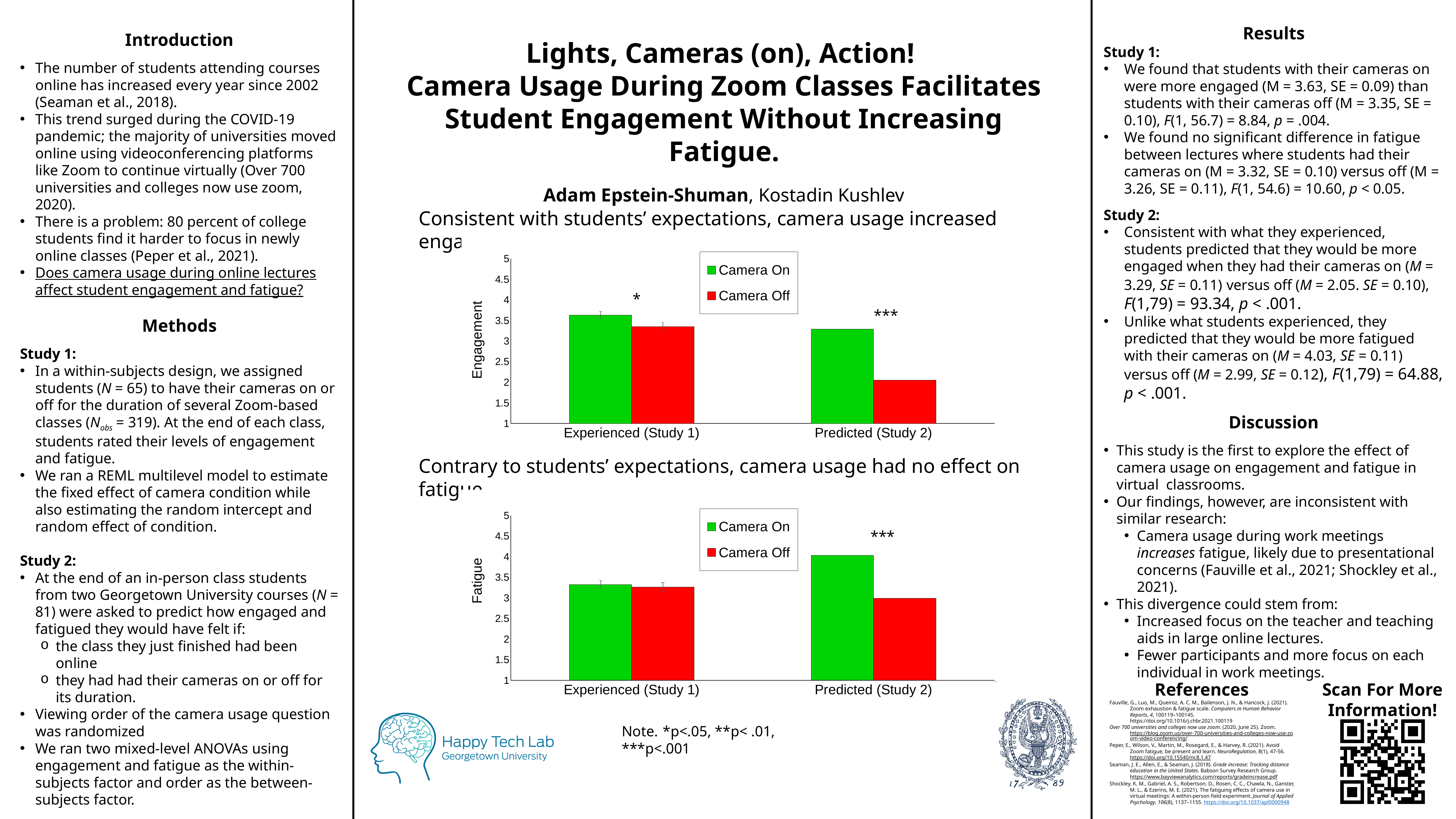
In the top chart (Engagement), how many categories are shown on the x axis? 2 In the bottom chart (Fatigue), what colour are the Camera On bars? green In the bottom chart (Fatigue), what is the highest value shown on the y axis? 5 What kind of chart is the top chart (Engagement)? bar chart In the top chart (Engagement), is the Camera On value for Experienced (Study 1) greater or less than 3? greater In the top chart (Engagement), for Predicted (Study 2), which is larger: Camera On or Camera Off? Camera On In the top chart (Engagement), what are the two legend entries? Camera On, Camera Off In the top chart (Engagement), is the Camera Off value for Predicted (Study 2) greater or less than 2.5? less In the top chart (Engagement), how many series does the legend list? 2 In the bottom chart (Fatigue), is the Camera Off value for Predicted (Study 2) greater or less than 3.5? less In the bottom chart (Fatigue), for Predicted (Study 2), which is larger: Camera On or Camera Off? Camera On